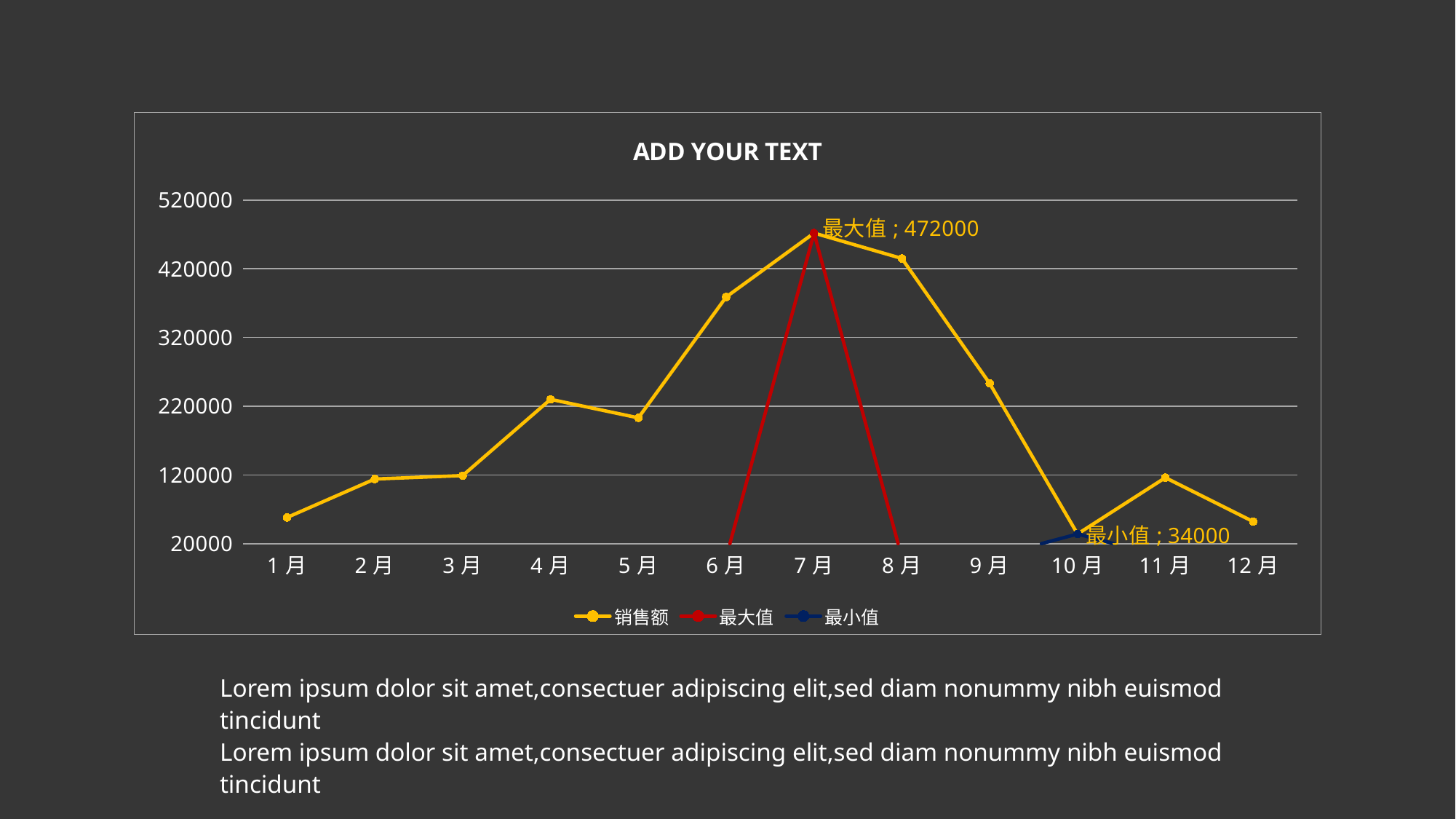
What is the difference between the labelled maximum (472000) and minimum (34000) values? 438000 Is the 销售额 value for 1月 greater or less than 120000? less What is the title of the chart? ADD YOUR TEXT How many months are shown on the x axis? 12 What kind of chart is shown on the slide? line chart Is the 销售额 value for 6月 greater or less than 320000? greater Which month has the larger 销售额 value, 4月 or 6月? 6月 What is the 最小值 (minimum) value labelled on the chart? 34000 What is the 最大值 (maximum) value labelled on the chart? 472000 How many series does the legend list? 3 Which month has the lowest 销售额 value? 10月 Which month has the highest 销售额 value? 7月